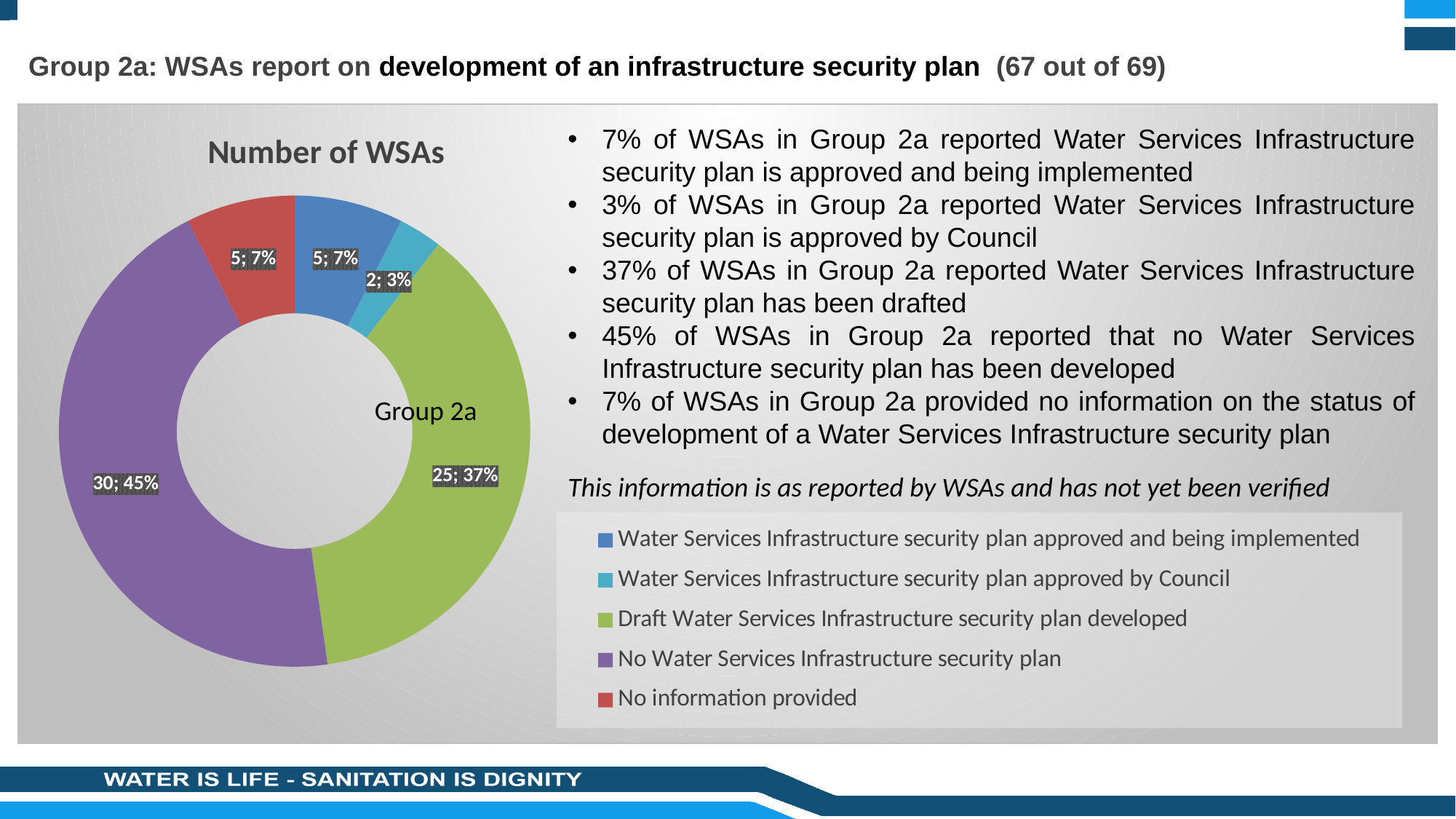
How many slices does the chart have? 5 How many entries does the chart legend list? 5 How many WSAs reported no Water Services Infrastructure security plan? 30 What kind of chart is shown on the slide? doughnut chart What is the title of the chart? Number of WSAs Which category has the largest slice in the chart? No Water Services Infrastructure security plan How many WSAs reported a Water Services Infrastructure security plan approved by Council? 2 What is the difference between the number of WSAs with no security plan and those with a draft plan developed? 5 How many WSAs reported a draft Water Services Infrastructure security plan developed? 25 Which is larger: the number of WSAs with a draft plan developed or the number with no security plan? No Water Services Infrastructure security plan Which category has the smallest slice in the chart? Water Services Infrastructure security plan approved by Council What share of the chart is the 'No Water Services Infrastructure security plan' slice? 45%